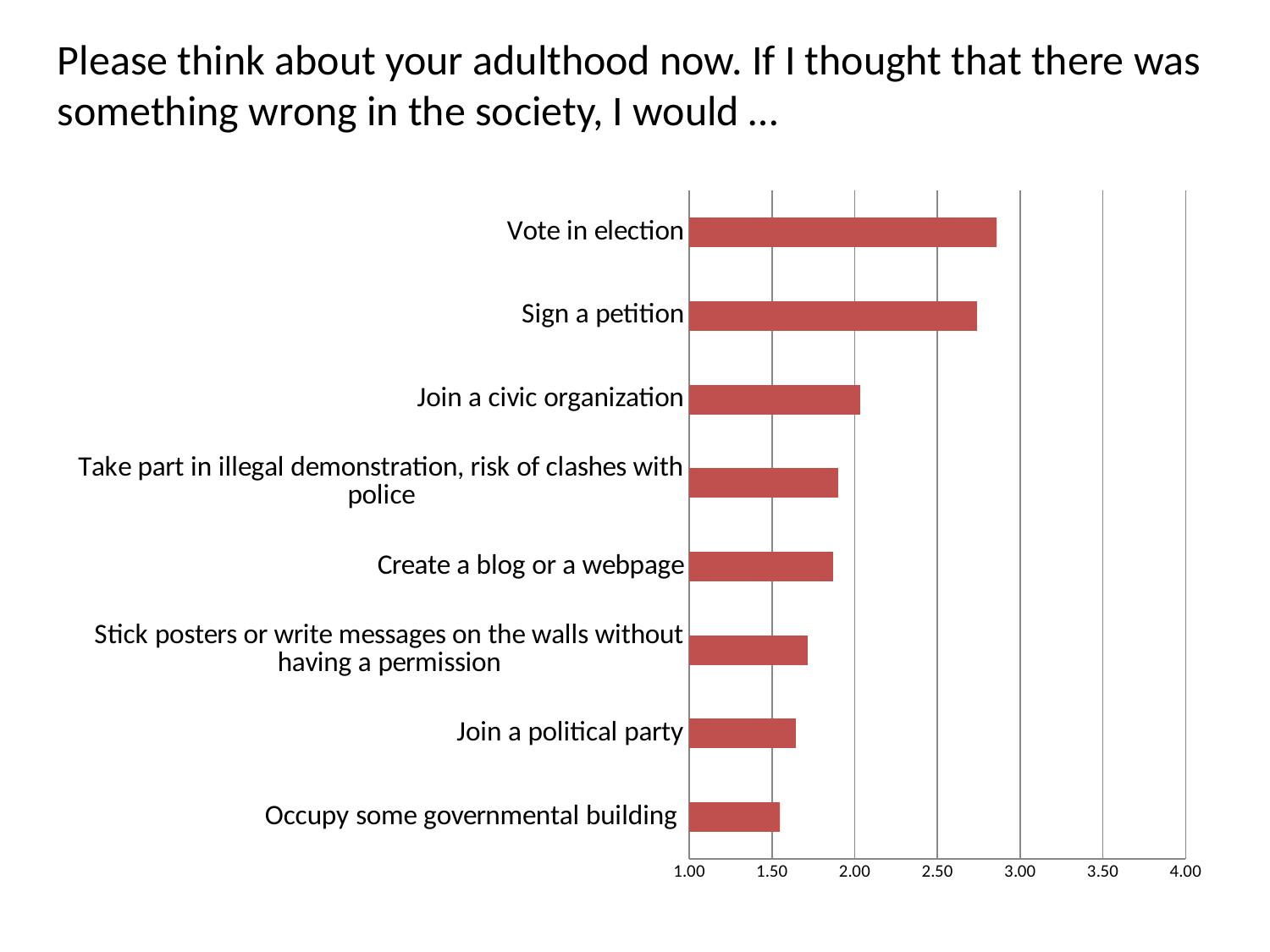
Which category has the lowest value in the chart? Occupy some governmental building What is the maximum value shown on the horizontal axis of the chart? 4.00 Which category has the highest value in the chart? Vote in election Which has a larger value: Sign a petition or Join a civic organization? Sign a petition How many categories (response options) are plotted in the chart? 8 Is the value for Vote in election greater or less than 2.50? greater Is the value for Vote in election greater or less than 3.00? less Which has a larger value: Vote in election or Join a political party? Vote in election Is the value for Sign a petition greater or less than 2.50? greater What kind of chart is shown on the slide? Bar chart